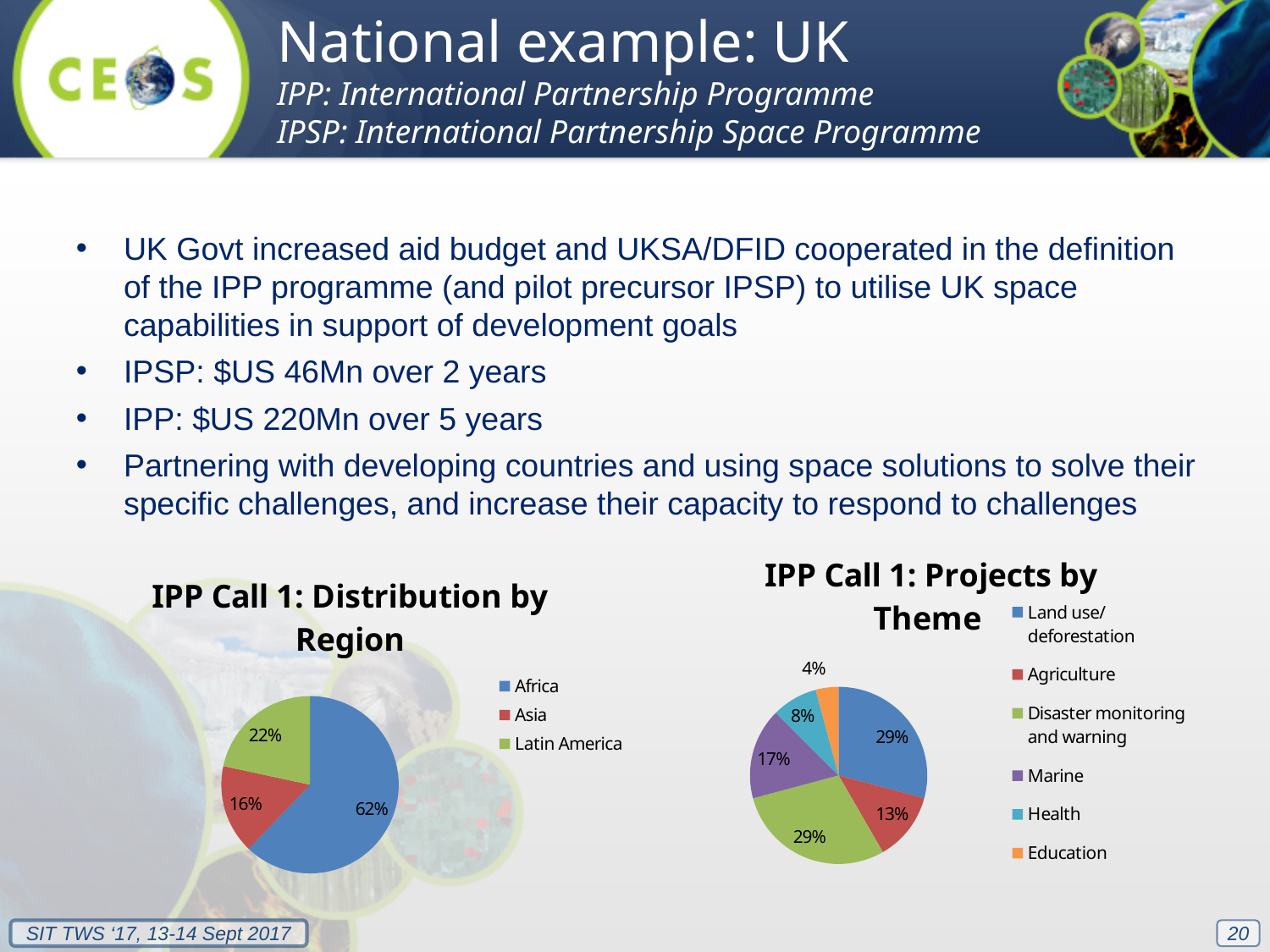
In the 'IPP Call 1: Distribution by Region' chart, how many percentage points larger is Africa's share than Latin America's? 40 In the 'IPP Call 1: Projects by Theme' chart, which theme has the smallest share? Education In the 'IPP Call 1: Projects by Theme' chart, which is larger, the share for Marine or the share for Health? Marine In the 'IPP Call 1: Distribution by Region' chart, what share does Asia have? 16% In the 'IPP Call 1: Projects by Theme' chart, what share do Agriculture projects have? 13% In the 'IPP Call 1: Distribution by Region' chart, which region has the smallest share? Asia In the 'IPP Call 1: Projects by Theme' chart, what share do Marine projects have? 17% How many themes does the legend of the 'IPP Call 1: Projects by Theme' chart list? 6 What kind of chart is 'IPP Call 1: Distribution by Region'? Pie chart In the 'IPP Call 1: Distribution by Region' chart, which region has the largest share? Africa How many regions does the legend of the 'IPP Call 1: Distribution by Region' chart list? 3 In the 'IPP Call 1: Distribution by Region' chart, what share does Africa have? 62%